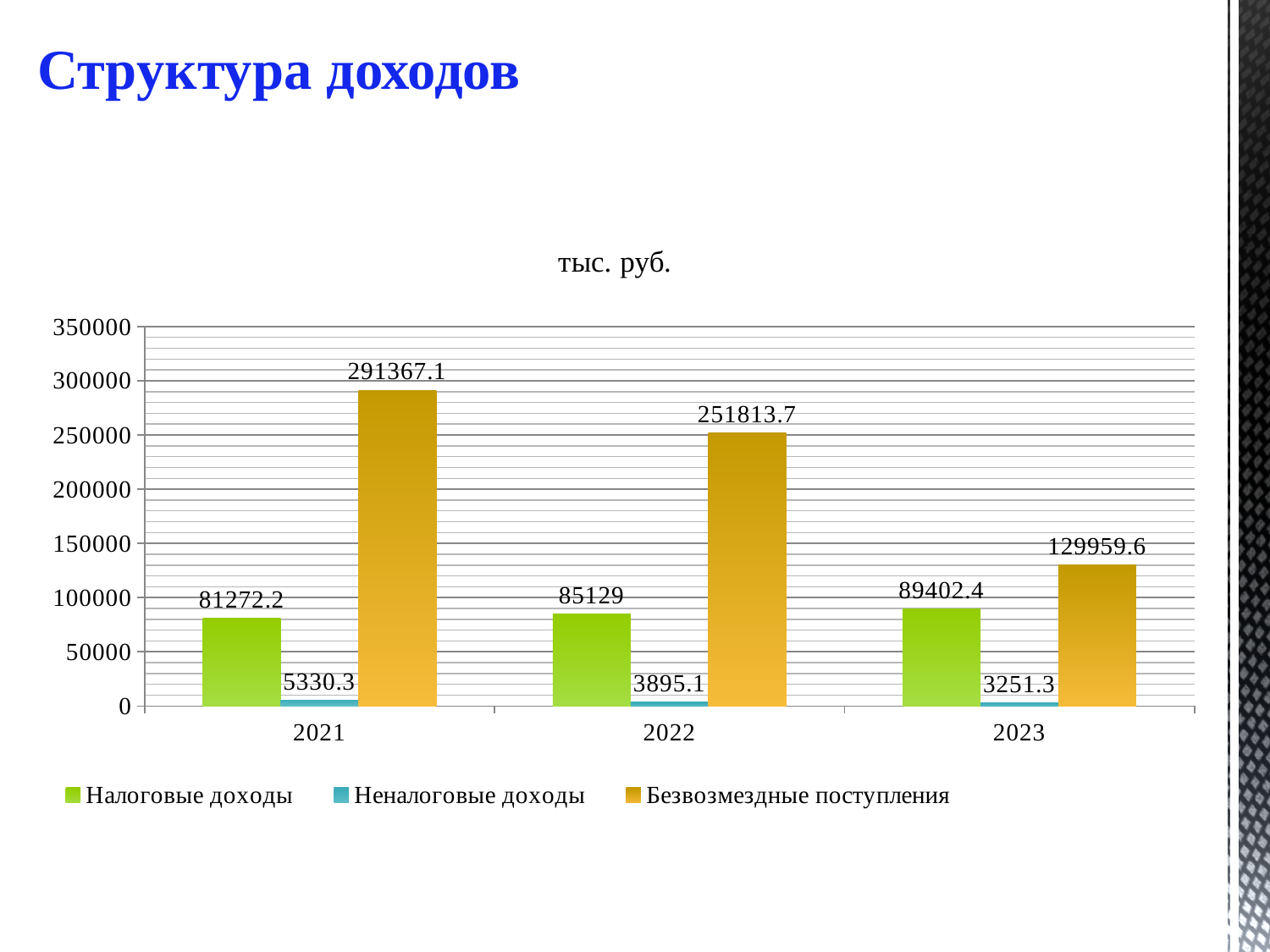
In which year is Налоговые доходы the highest? 2023 Do the values for Безвозмездные поступления rise or fall from 2021 to 2023? fall What kind of chart is shown on the slide? bar chart What is the difference between Безвозмездные поступления in 2021 and in 2022? 39553.4 What is the value of Налоговые доходы in 2022? 85129 In which year is Безвозмездные поступления the lowest? 2023 Which is larger in 2023: Налоговые доходы or Безвозмездные поступления? Безвозмездные поступления By how much did Налоговые доходы increase from 2021 to 2023? 8130.2 What is the value of Безвозмездные поступления in 2021? 291367.1 How many series does the legend list? 3 What is the value of Неналоговые доходы in 2023? 3251.3 How many years are shown on the x axis? 3